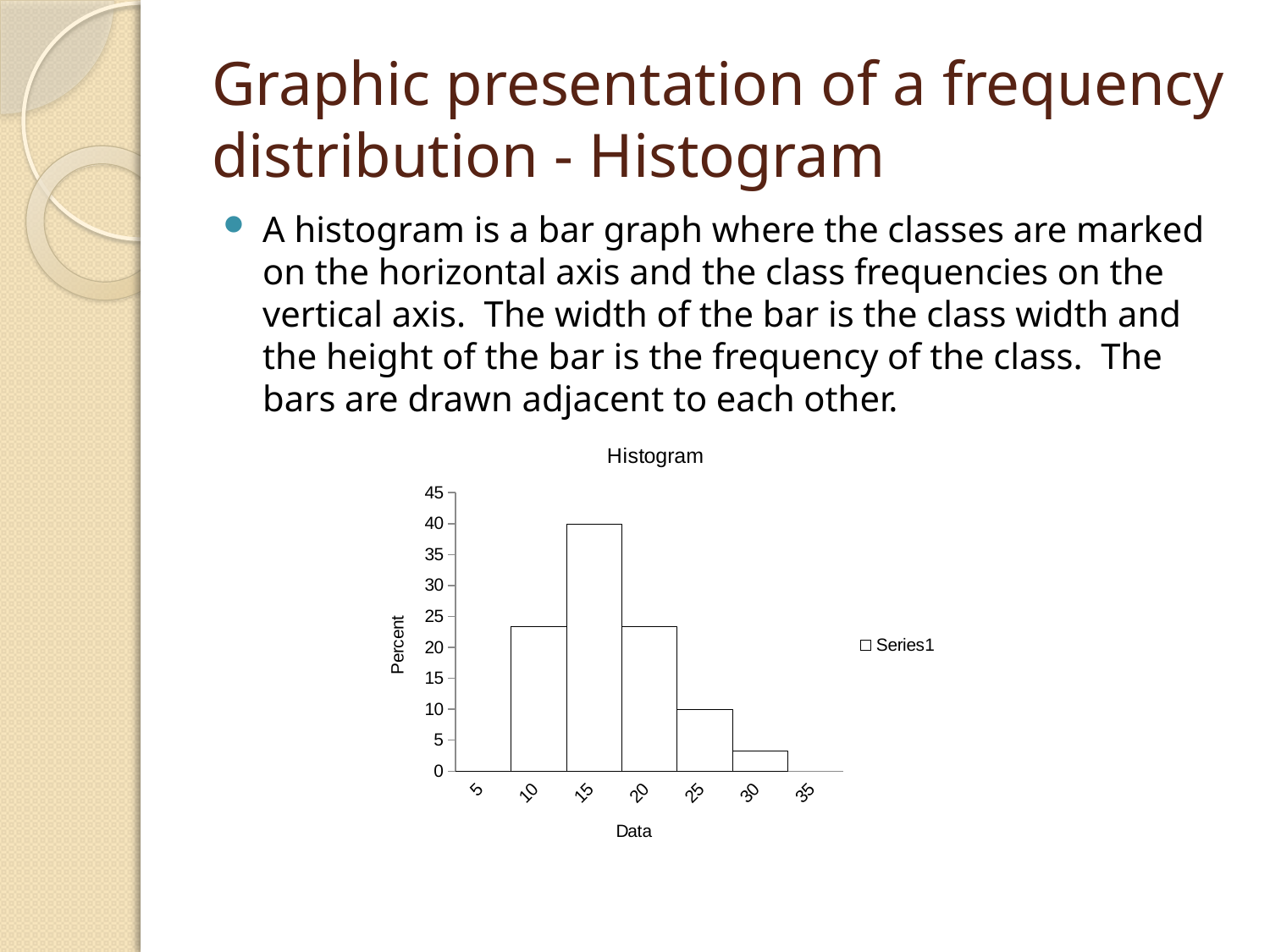
Which is larger, the value for category 20 or the value for category 25? 20 What is the title of the chart? Histogram How many categories are marked on the horizontal axis? 7 How many series does the legend list? 1 Is the value for category 10 greater or less than 20? greater Is the value for category 30 greater or less than 5? less What is the difference between the values for categories 15 and 25? 30 Which category has the tallest bar? 15 What is the value for category 25? 10 What is the label of the vertical axis? Percent What kind of chart is shown on the slide? bar chart What is the value for category 15? 40